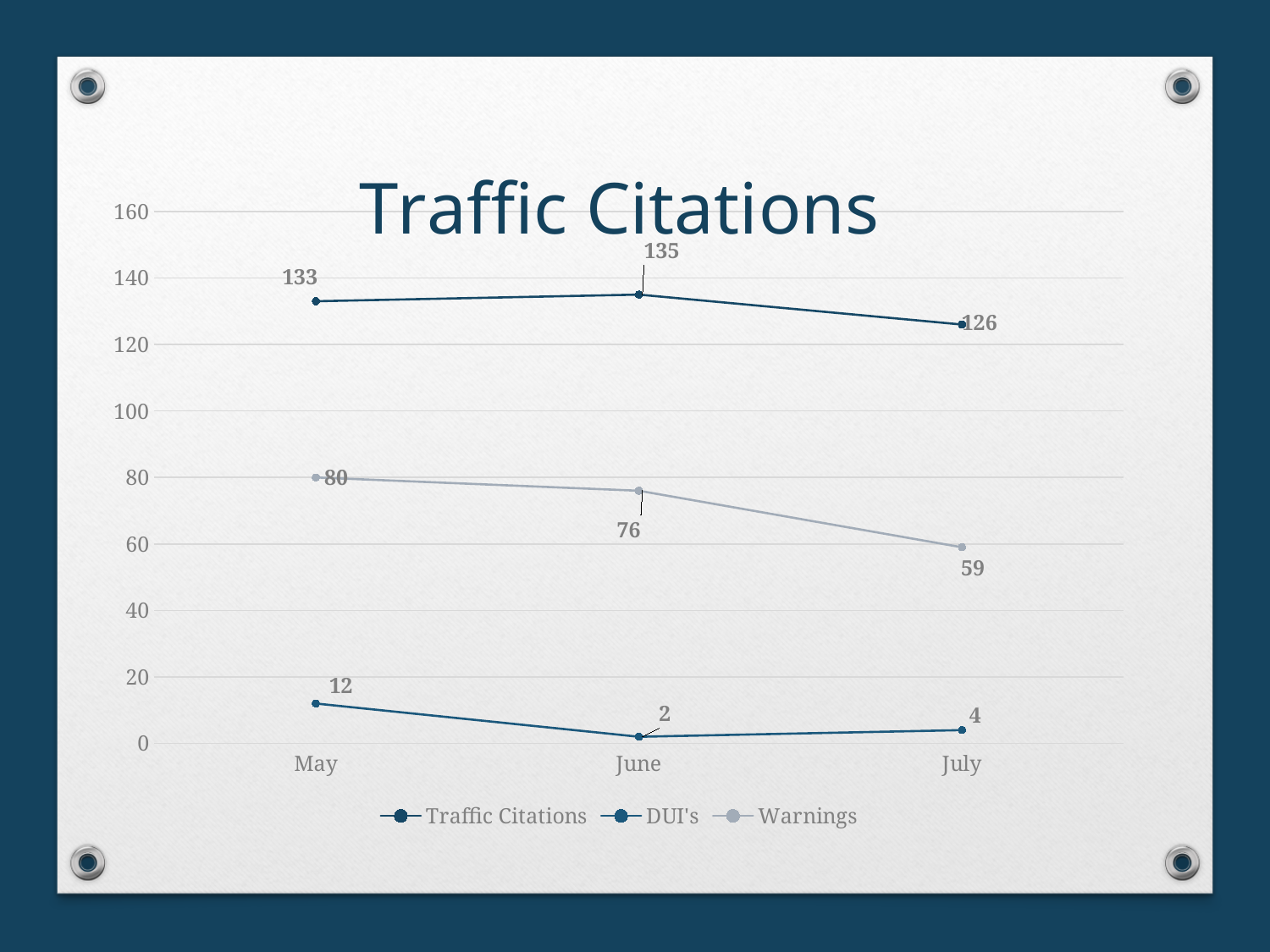
In which month is the DUI's value lowest? June Which is larger, Warnings in June or Warnings in July? Warnings in June What is the value for Warnings in July? 59 In which month is the Traffic Citations value highest? June What is the difference between Warnings in May and July? 21 How many months are shown on the x axis? 3 What is the difference between Traffic Citations in May and July? 7 How many series does the legend list? 3 What is the value for DUI's in May? 12 What kind of chart is shown on the slide? Line chart Is the value for Traffic Citations in July greater or less than 120? greater What is the value for Traffic Citations in June? 135